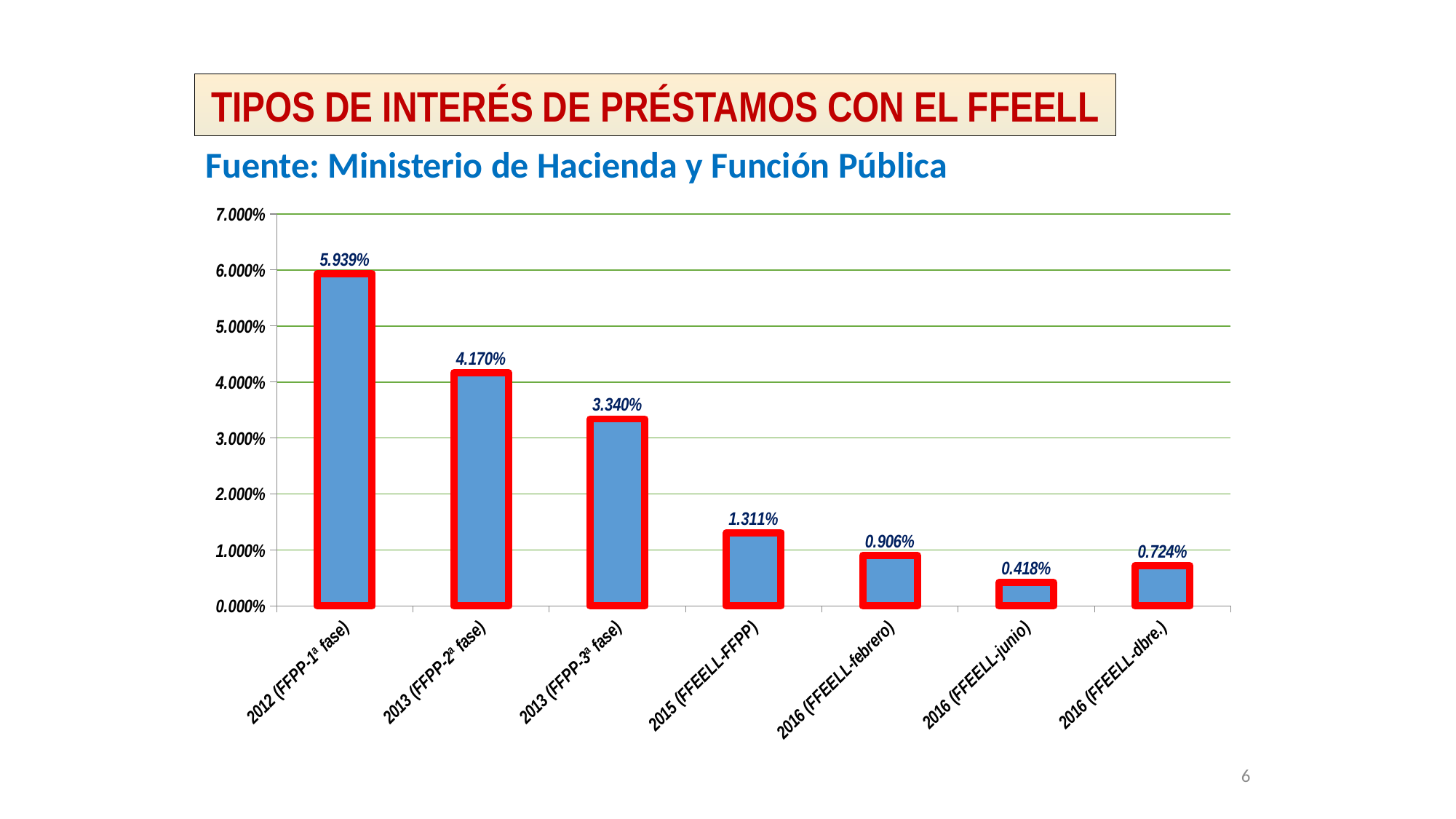
Which is larger, the value for 2016 (FFEELL-febrero) or 2016 (FFEELL-dbre.)? 2016 (FFEELL-febrero) What kind of chart is shown on the slide? bar chart How many categories are shown on the x axis? 7 Which category has the highest value? 2012 (FFPP-1ª fase) Is the value for 2013 (FFPP-3ª fase) greater or less than 3.000%? greater Which category has the lowest value? 2016 (FFEELL-junio) What is the value for 2016 (FFEELL-junio)? 0.418% What is the difference between the values for 2013 (FFPP-2ª fase) and 2013 (FFPP-3ª fase)? 0.830% What is the value for 2015 (FFEELL-FFPP)? 1.311% What is the value for 2012 (FFPP-1ª fase)? 5.939% What is the title of the slide? TIPOS DE INTERÉS DE PRÉSTAMOS CON EL FFEELL Do the values generally rise or fall from 2012 (FFPP-1ª fase) to 2016 (FFEELL-junio)? fall